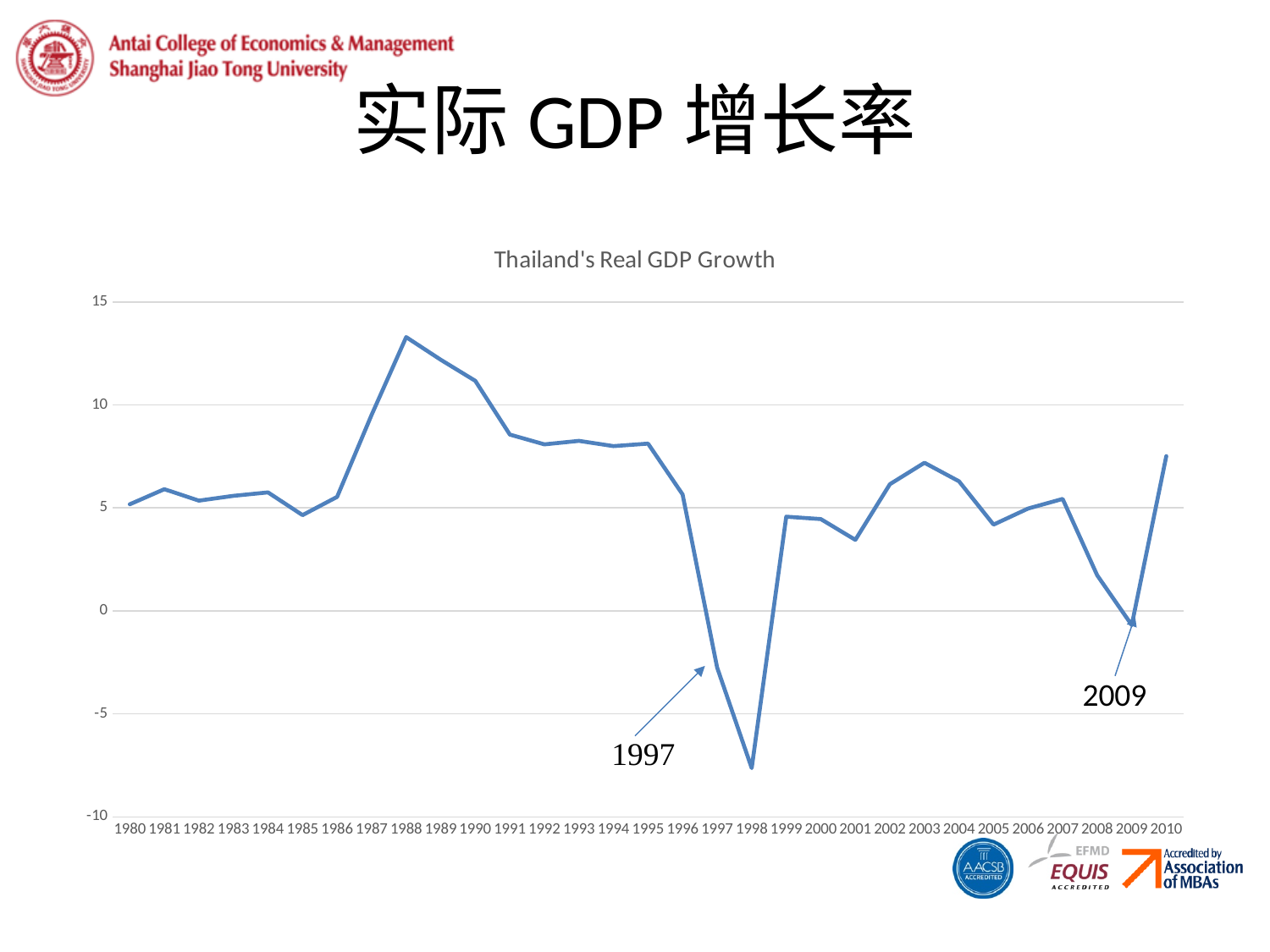
Is the value for 1988 greater or less than 10? greater Is the value for 2008 greater or less than 5? less In which year does Thailand's real GDP growth reach its lowest point? 1998 Is the value for 1998 greater or less than -5? less Which two years are called out with arrow annotations on the chart? 1997 and 2009 Which year has the higher real GDP growth, 2003 or 2005? 2003 In which year does Thailand's real GDP growth reach its highest point? 1988 How many years are plotted on the x axis of the chart? 31 What kind of chart is shown on the slide? Line chart What is the title of the chart? Thailand's Real GDP Growth Does Thailand's real GDP growth rise or fall from 1988 to 1998? Fall